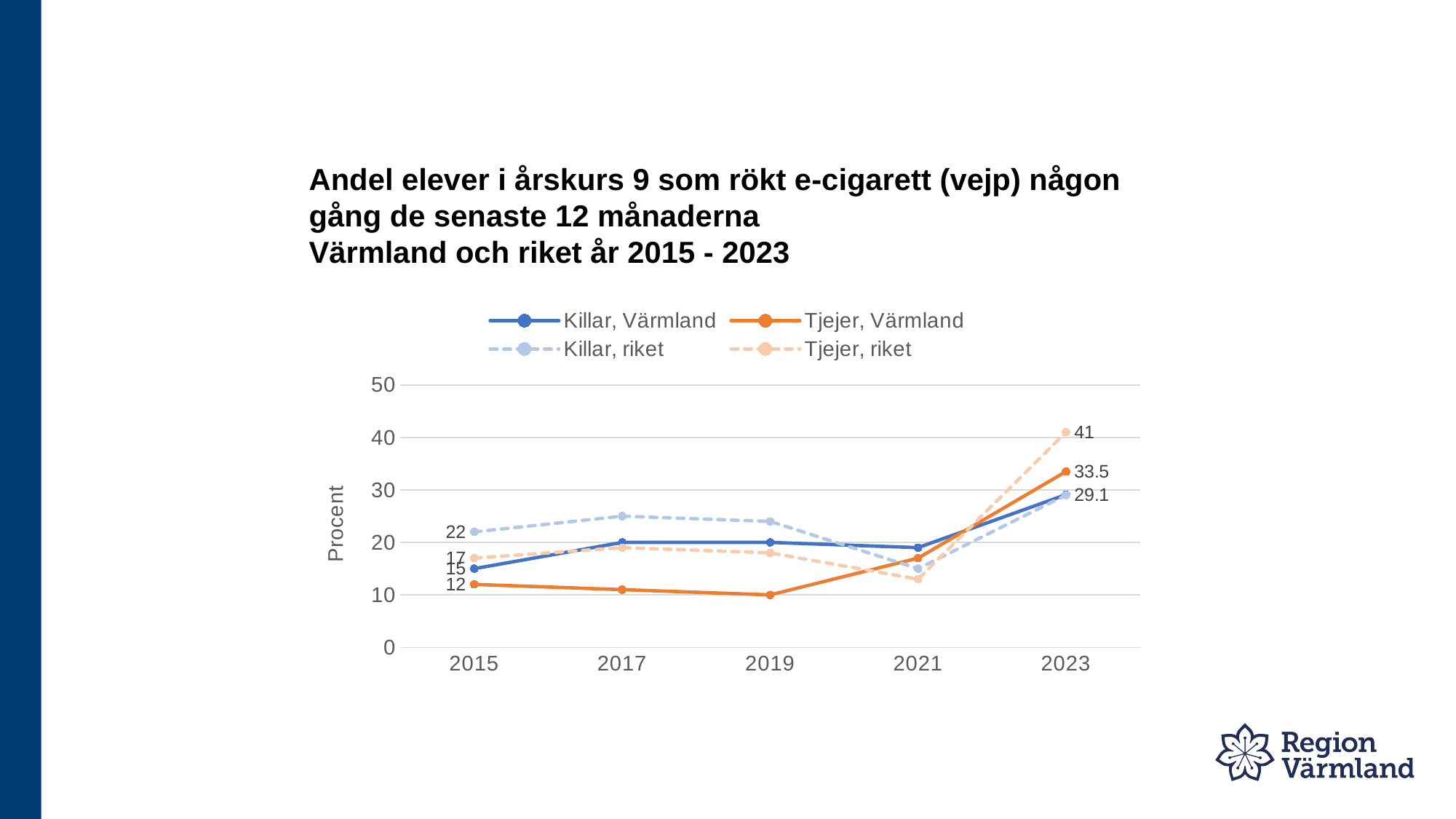
How many years are shown on the x axis? 5 What is the value for Killar, Värmland in 2015? 15 Which series has the highest value in 2023? Tjejer, riket What is the difference between Tjejer, riket and Tjejer, Värmland in 2023? 7.5 What is the value for Tjejer, Värmland in 2023? 33.5 What is the label on the y axis? Procent What kind of chart is shown on the slide? line chart What is the value for Tjejer, riket in 2023? 41 How many series does the legend list? 4 Is the value for Tjejer, Värmland in 2019 greater or less than 20? less Which series has the lowest value in 2015? Tjejer, Värmland What is the value for Killar, riket in 2015? 22